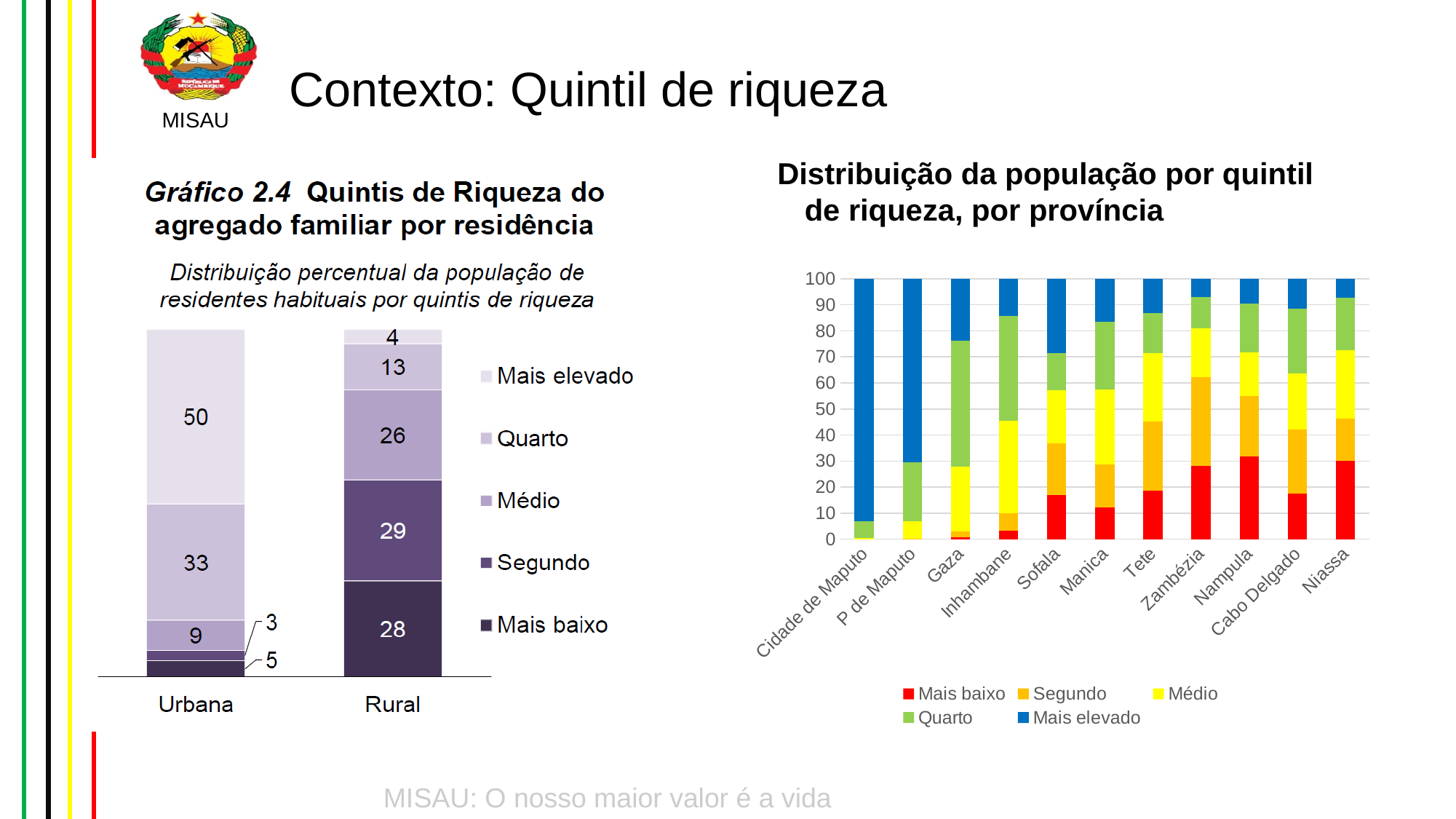
In the chart 'Gráfico 2.4', which quintile has the largest value in the Rural bar? Segundo In the chart 'Distribuição da população por quintil de riqueza, por província', how many series does the legend list? 5 In the chart 'Gráfico 2.4 Quintis de Riqueza do agregado familiar por residência', what kind of chart is shown? Stacked bar chart In the chart 'Gráfico 2.4', what is the value of 'Mais baixo' for Rural? 28 In the chart 'Distribuição da população por quintil de riqueza, por província', is the 'Mais baixo' value for Gaza greater or less than 10? less In the chart 'Distribuição da população por quintil de riqueza, por província', what colour represents 'Mais baixo' in the legend? Red In the chart 'Distribuição da população por quintil de riqueza, por província', is the 'Mais baixo' value for Sofala greater or less than 10? greater In the chart 'Distribuição da população por quintil de riqueza, por província', how many provinces are shown on the x axis? 11 In the chart 'Gráfico 2.4', what is the difference between the 'Quarto' value for Urbana and the 'Quarto' value for Rural? 20 In the chart 'Gráfico 2.4', what is the value of 'Mais elevado' for Urbana? 50 In the chart 'Gráfico 2.4', which quintile has the smallest value in the Urbana bar? Segundo In the chart 'Gráfico 2.4', which is larger for Rural: 'Segundo' or 'Médio'? Segundo